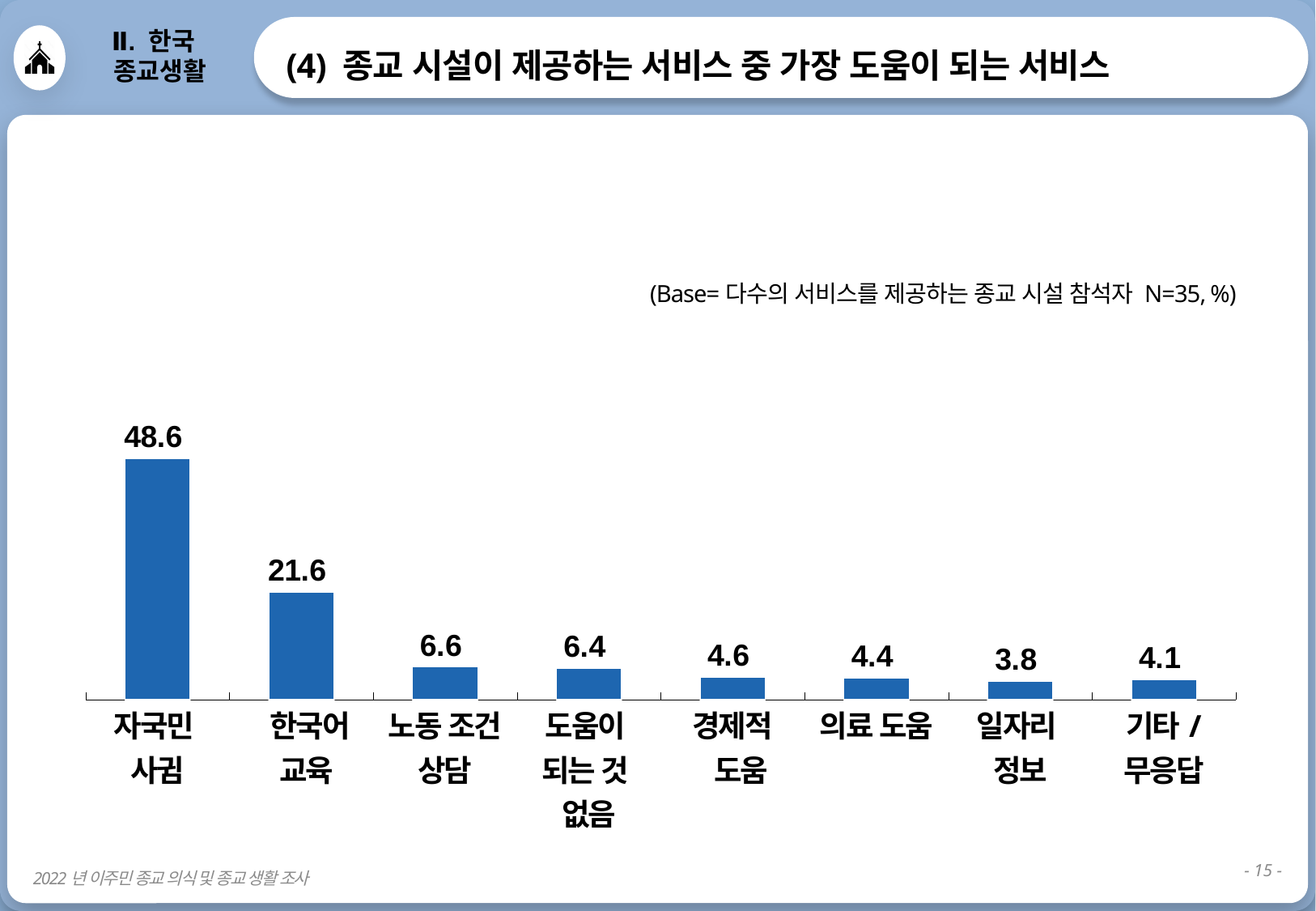
What is the value for 한국어 교육? 21.6 Which category has the lowest value? 일자리 정보 What is the difference between the values for 노동 조건 상담 and 도움이 되는 것 없음? 0.2 Which is larger, the value for 경제적 도움 or the value for 일자리 정보? 경제적 도움 What is the value for 의료 도움? 4.4 What is the value for 기타 / 무응답? 4.1 How many categories are shown in the chart? 8 What is the value for 자국민 사귐? 48.6 What is the difference between the values for 자국민 사귐 and 한국어 교육? 27 Which category has the highest value? 자국민 사귐 What kind of chart is shown on the slide? bar chart What is the base (N) stated for the chart? N=35